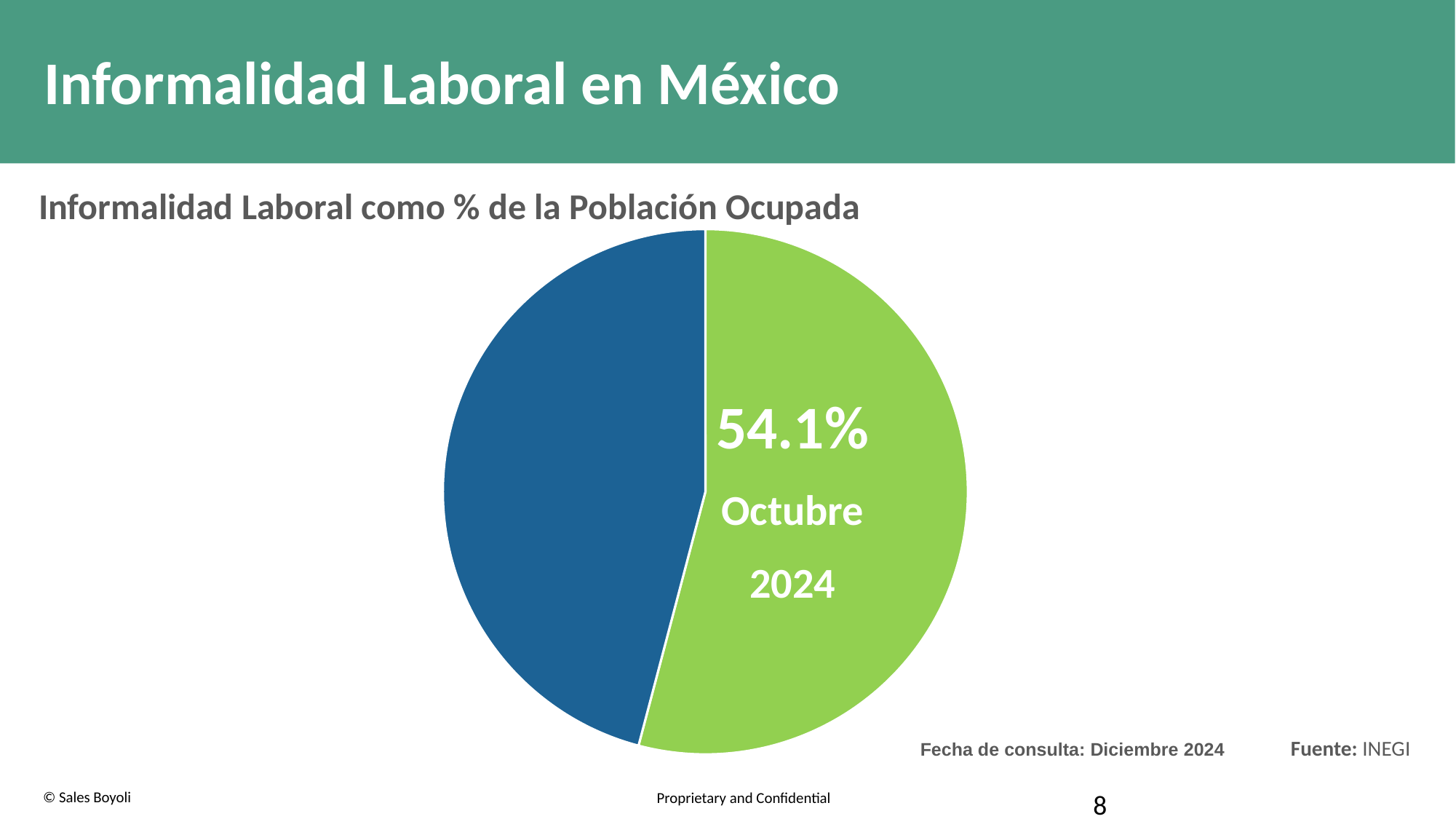
What is the labor informality rate shown for Octubre 2024? 54.1% How many slices does the pie chart have? 2 Which slice of the pie chart is the largest? the green slice (54.1%) Which slice of the pie chart is the smallest? the blue slice Is the share of the green slice greater or less than 50%? greater Which slice of the pie chart is larger, the green one or the blue one? green What is the title of the chart? Informalidad Laboral como % de la Población Ocupada What month and year are labeled on the pie chart? Octubre 2024 What kind of chart is shown on the slide? pie chart What value is printed on the green slice of the pie chart? 54.1%